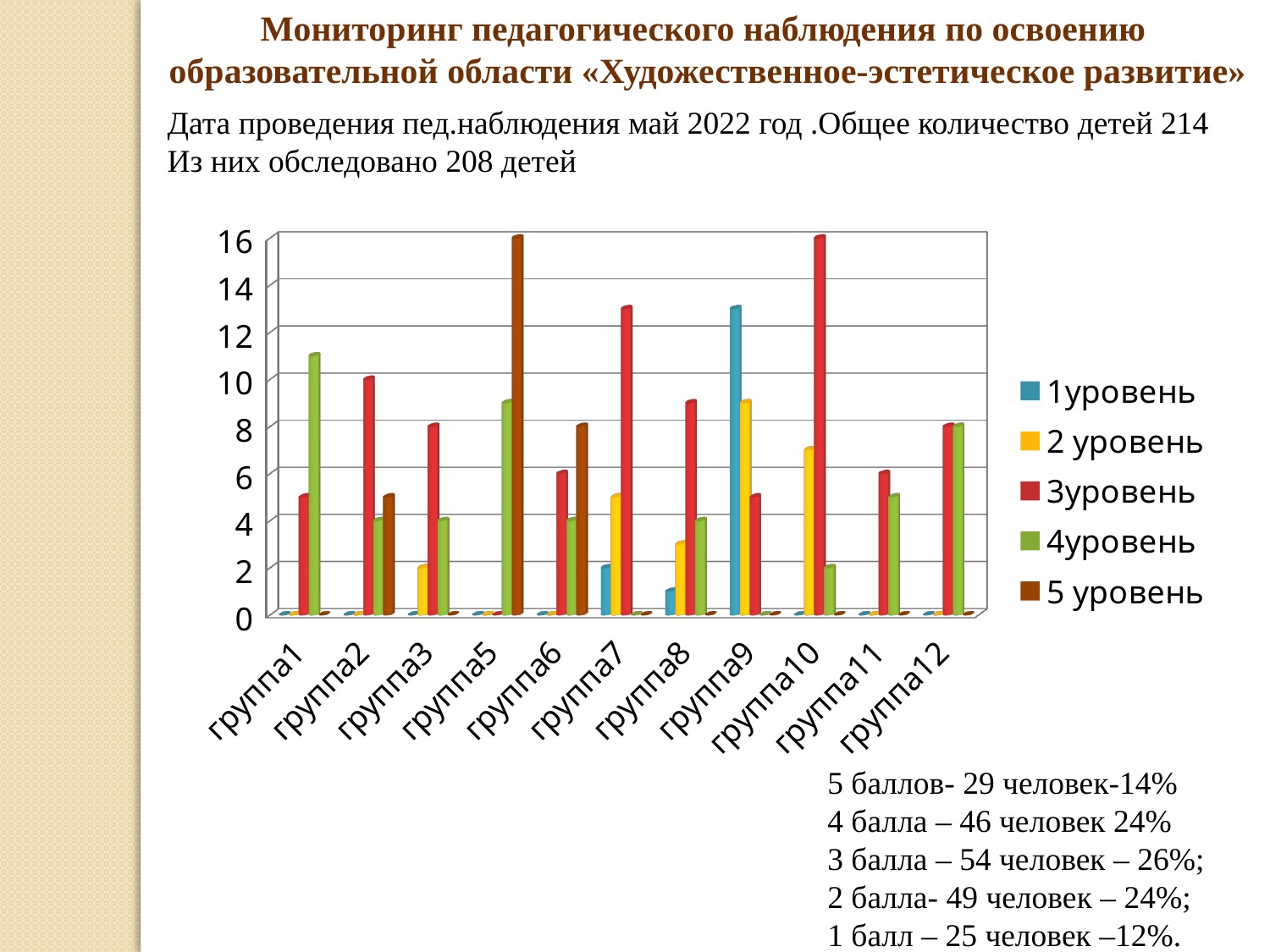
What kind of chart is shown on the slide? bar chart Is the value of "4уровень" for группа10 greater or less than 4? less Which group has the tallest bar for the series "1уровень"? группа9 Which group has the tallest bar for the series "3уровень"? группа10 How many groups (categories) are shown on the x axis of the chart? 11 For группа1, which series has the larger value: "3уровень" or "4уровень"? 4уровень Which series is shown in brown in the chart legend? 5 уровень How many series does the chart legend list? 5 Is the value of "1уровень" for группа9 greater or less than 10? greater Is the value of "5 уровень" for группа5 greater or less than 14? greater Which group has the tallest bar for the series "5 уровень"? группа5